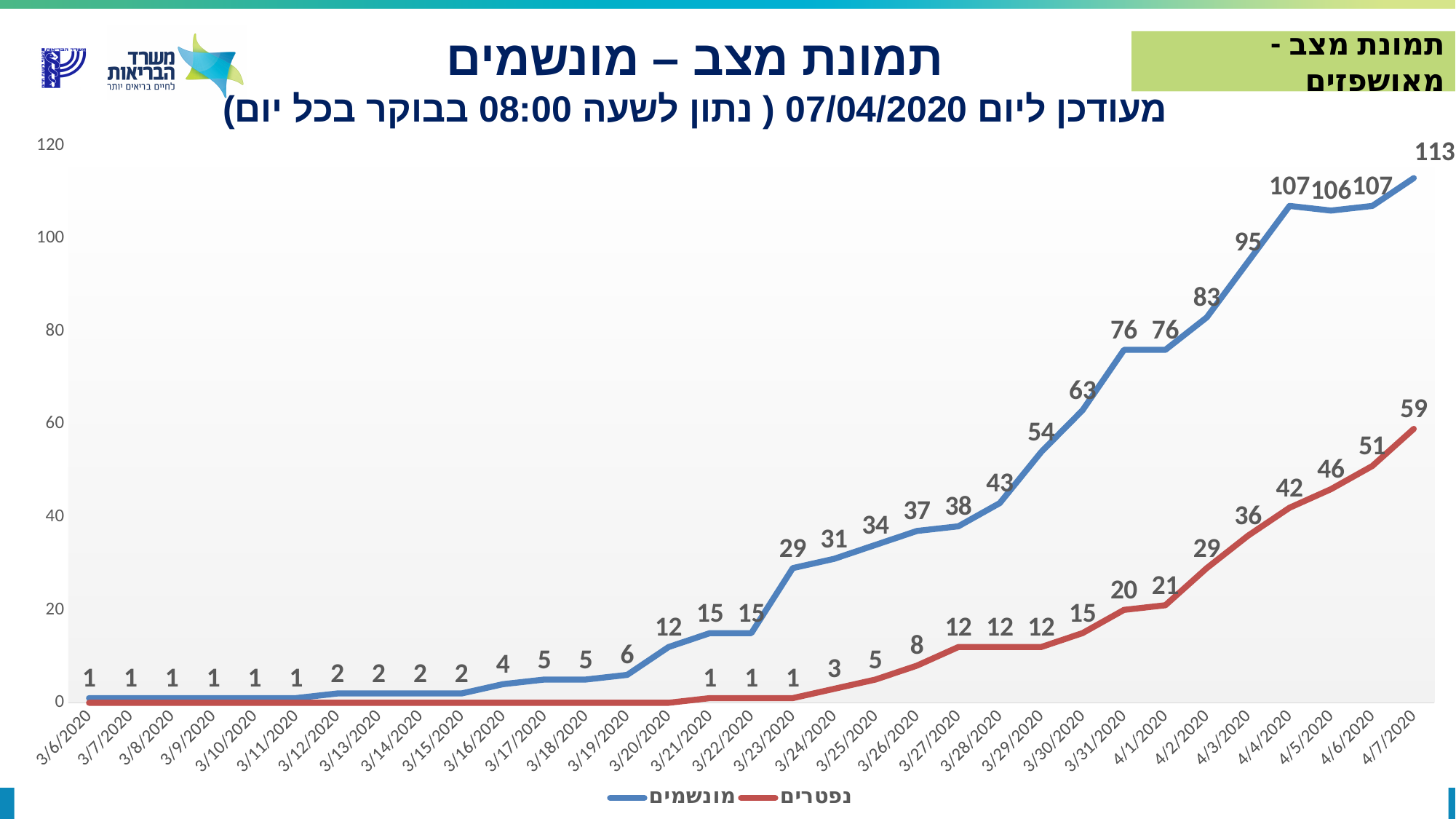
What type of chart is shown on the slide? line chart What is the value of the נפטרים series on 4/7/2020? 59 On which date does the מונשמים series reach its highest value? 4/7/2020 What is the difference between the מונשמים and נפטרים values on 4/7/2020? 54 What is the value of the נפטרים series on 3/31/2020? 20 What is the value of the מונשמים series on 4/7/2020? 113 What is the value of the מונשמים series on 3/23/2020? 29 How many dates are shown on the x axis? 33 Does the מונשמים series generally rise or fall from 3/6/2020 to 4/7/2020? rise What colour is the line for the נפטרים series? red Which series has the larger value on 4/4/2020, מונשמים or נפטרים? מונשמים How many series does the legend list? 2